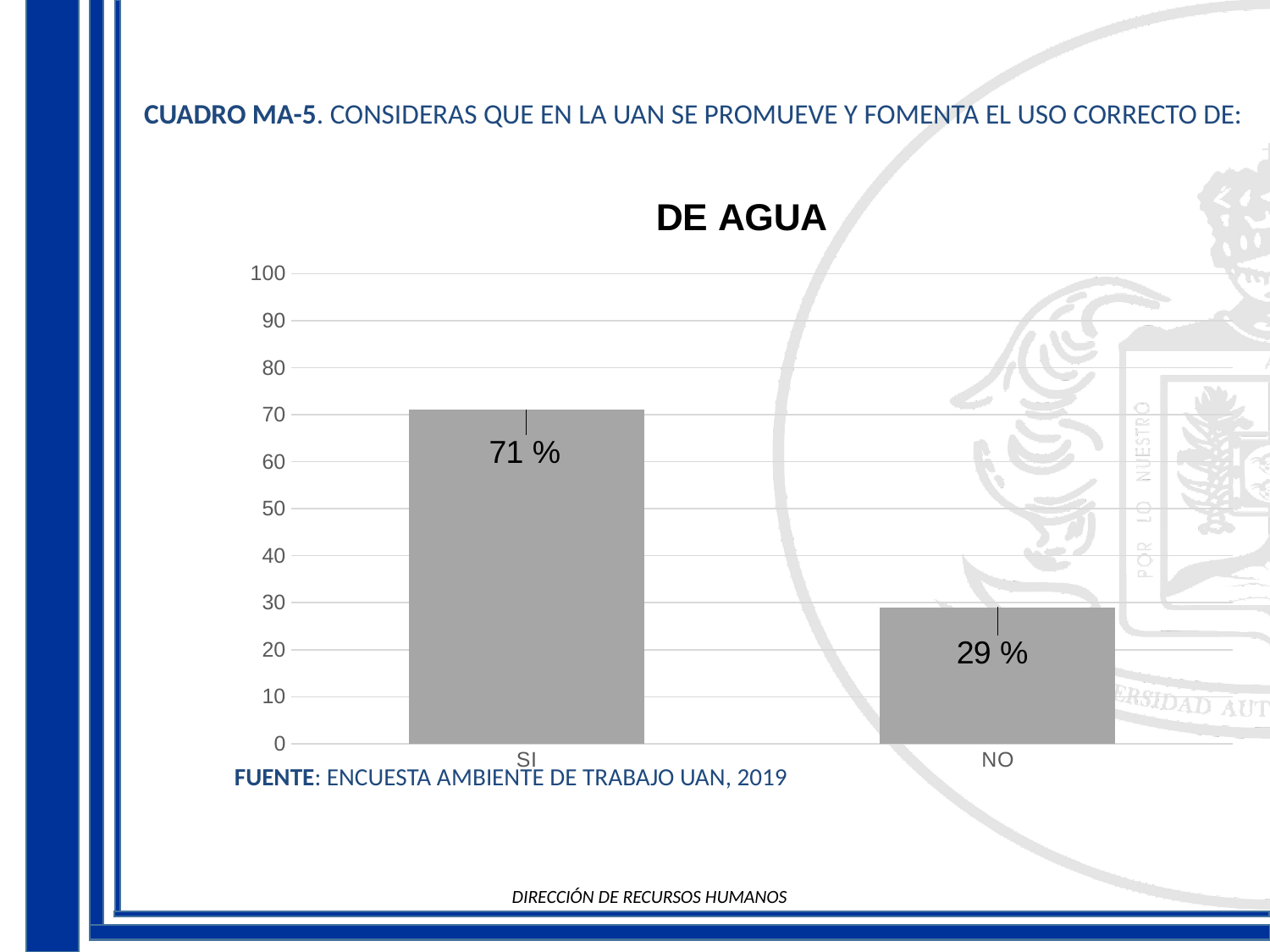
What is the value for NO? 29 % Which is larger, the value for SI or the value for NO? SI Which category has the highest value? SI What is the title of the chart? DE AGUA What kind of chart is shown on the slide? bar chart How many categories are shown on the x axis? 2 What is the difference between the values for SI and NO? 42 % Is the value for SI greater or less than 50? greater Is the value for NO greater or less than 40? less Which category has the lowest value? NO What is the maximum value shown on the y axis? 100 What is the value for SI? 71 %